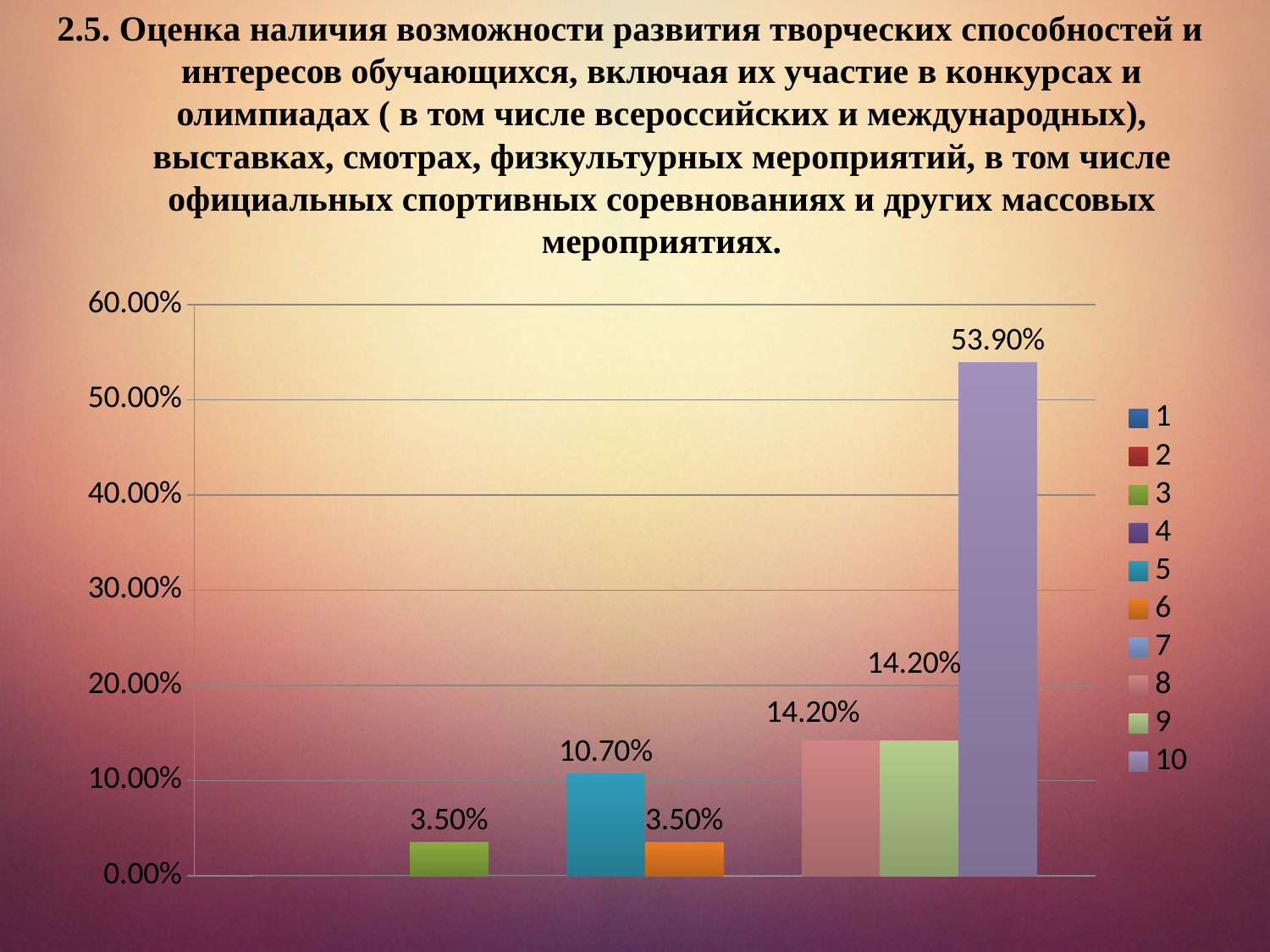
Which is larger, the value for series 5 or the value for series 8? series 8 What is the difference between the values for series 10 and series 9? 39.70% What is the difference between the values for series 5 and series 3? 7.20% Is the value for series 10 greater or less than 50.00%? greater What colour is the bar for series 10? purple What kind of chart is shown on the slide? bar chart What value is shown for series 10? 53.90% How many series does the legend list? 10 What value is shown for series 5? 10.70% What value is shown for series 8? 14.20% Which series has the highest value? 10 What value is shown for series 6? 3.50%